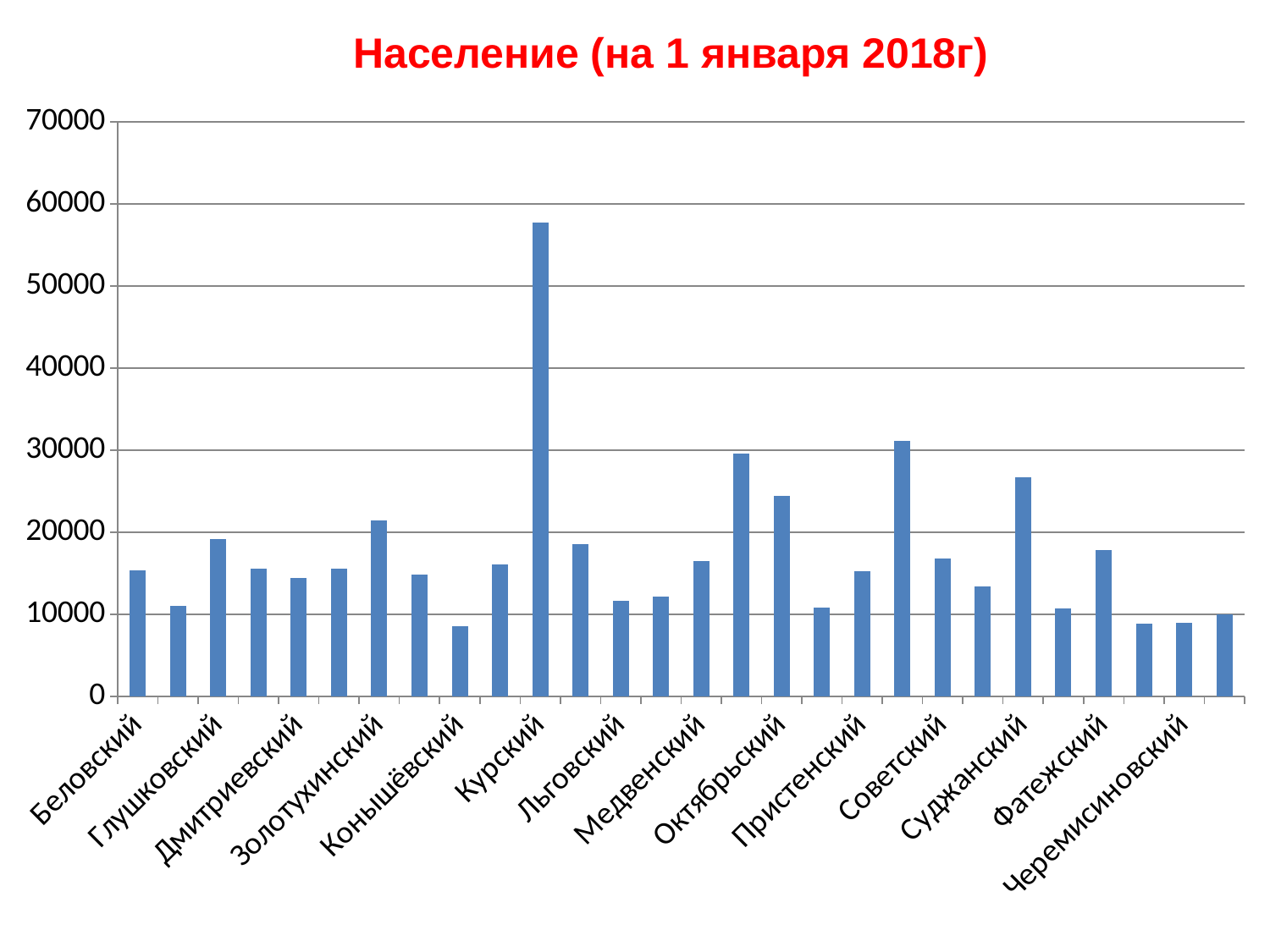
Which category has the highest value? Курский Is the value for Беловский greater or less than 10000? greater Is the value for Суджанский greater or less than 20000? greater Which is larger, the value for Глушковский or the value for Беловский? Глушковский Is the value for Курский greater or less than 50000? greater What is the title of the chart? Население (на 1 января 2018г) What kind of chart is shown on the slide? bar chart Which is larger, the value for Октябрьский or the value for Пристенский? Октябрьский Which is larger, the value for Курский or the value for Суджанский? Курский